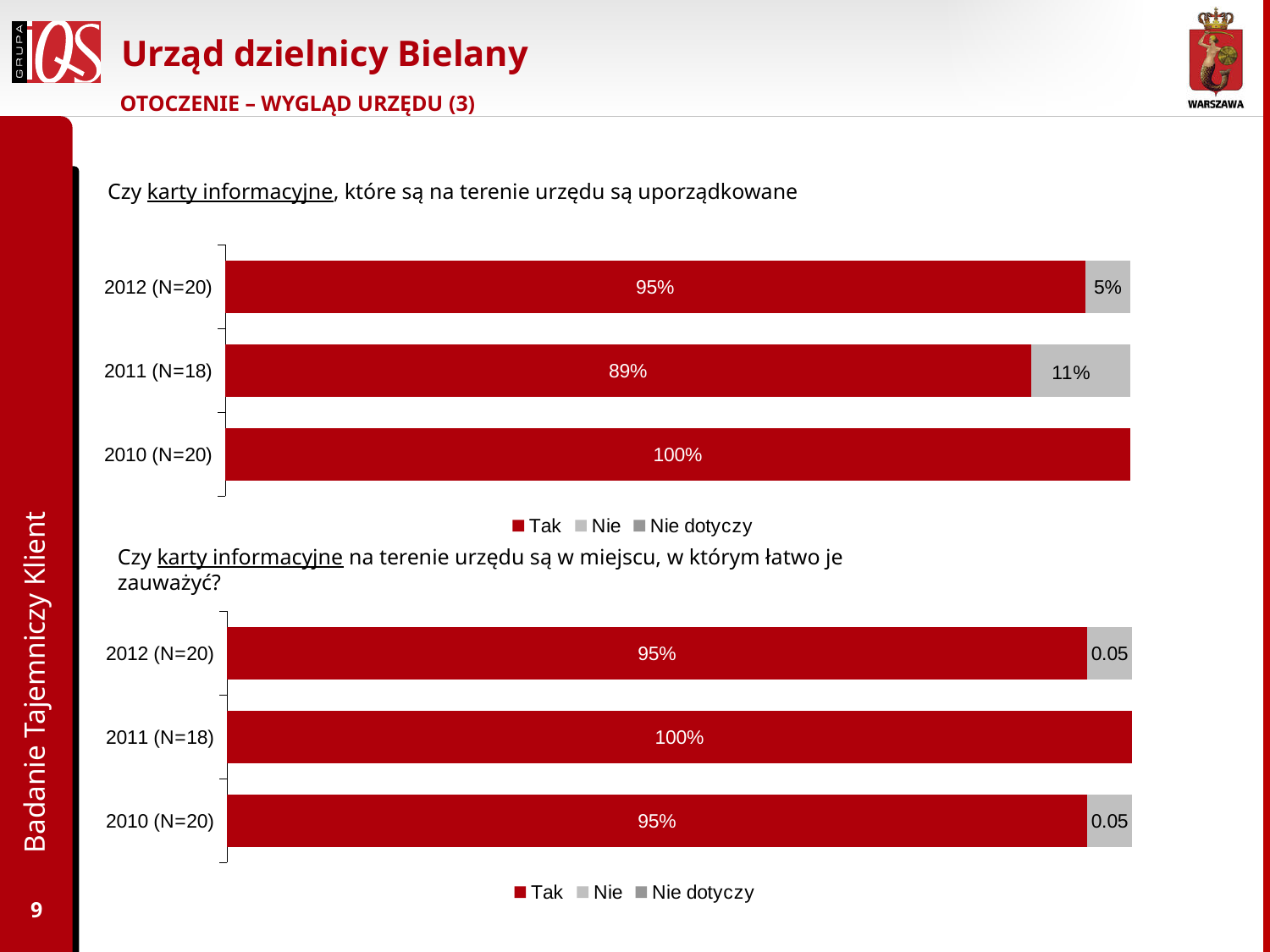
In the top chart, what is the difference between the 'Tak' values for 2012 (N=20) and 2011 (N=18)? 6% In the top chart, which year has the lowest 'Tak' value? 2011 (N=18) What kind of chart is the top chart? Stacked bar chart In the bottom chart, which year has the highest 'Tak' value? 2011 (N=18) In the top chart, what is the 'Tak' value for 2011 (N=18)? 89% In the bottom chart, what is the 'Nie' value shown for 2010 (N=20)? 0.05 In the top chart, what is the 'Nie' value for 2011 (N=18)? 11% In the bottom chart, what is the 'Tak' value for 2011 (N=18)? 100% In the top chart, what is the 'Nie' value for 2012 (N=20)? 5% In the top chart, which year has the highest 'Tak' value? 2010 (N=20) How many year categories are shown in the bottom chart? 3 How many series does the legend of the top chart list? 3